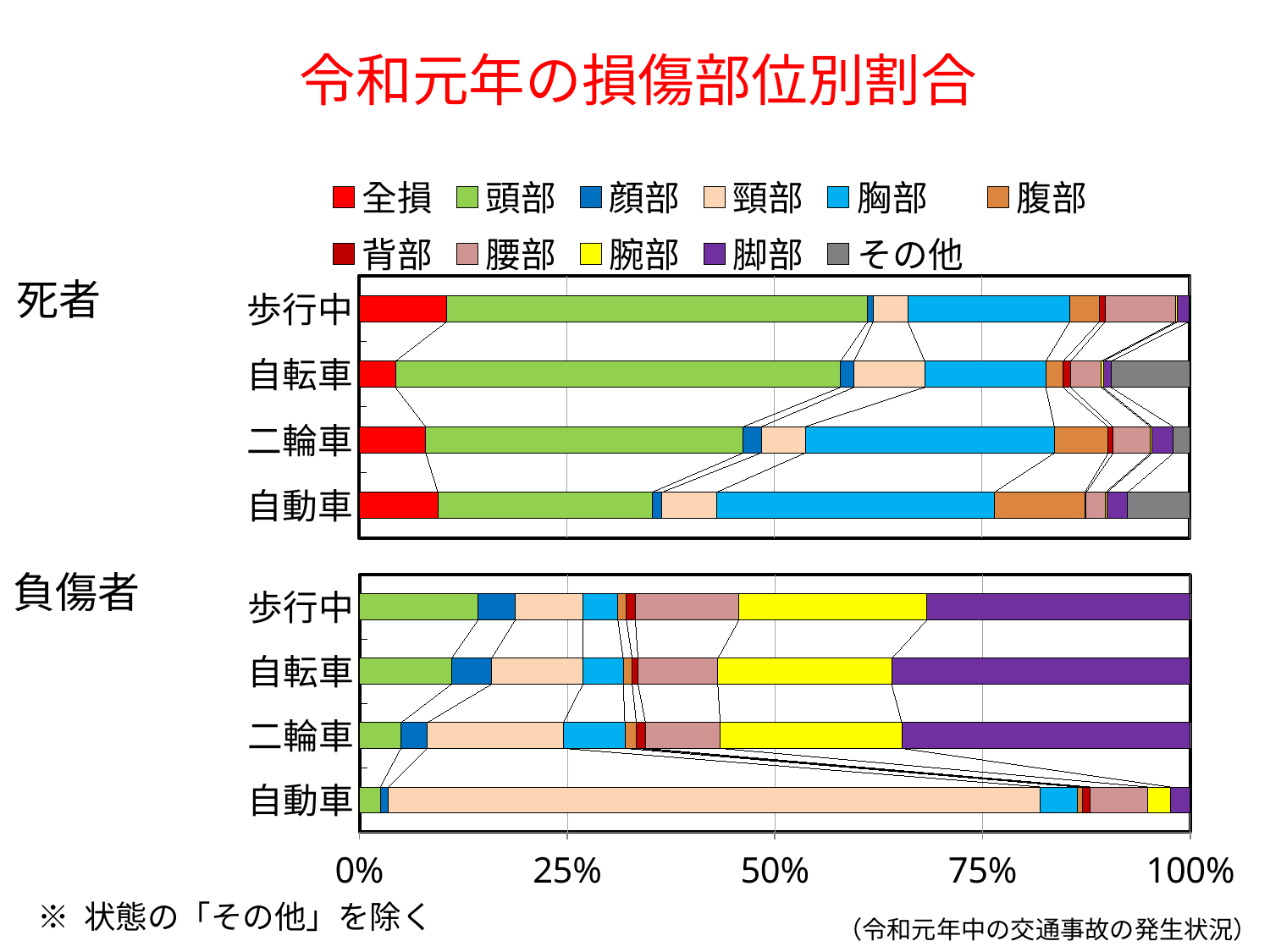
In the 死者 chart, which has the larger 胸部 share, 自動車 or 歩行中? 自動車 In the 死者 chart, is the 胸部 share for 自動車 greater or less than 25%? greater In the 負傷者 chart, is the 脚部 share for 歩行中 greater or less than 25%? greater In the legend, which colour represents 脚部? Purple In the 負傷者 chart, is the 頸部 share for 自動車 greater or less than 75%? greater What kind of chart is used for the 死者 chart? Stacked bar chart What is the title of the slide's chart? 令和元年の損傷部位別割合 In the 負傷者 chart, which category has the smallest 頭部 share? 自動車 In the 負傷者 chart, which has the larger 脚部 share, 歩行中 or 自動車? 歩行中 How many categories are shown in the 負傷者 chart? 4 In the 負傷者 chart, which category has the largest 頸部 share? 自動車 How many series does the legend list? 11